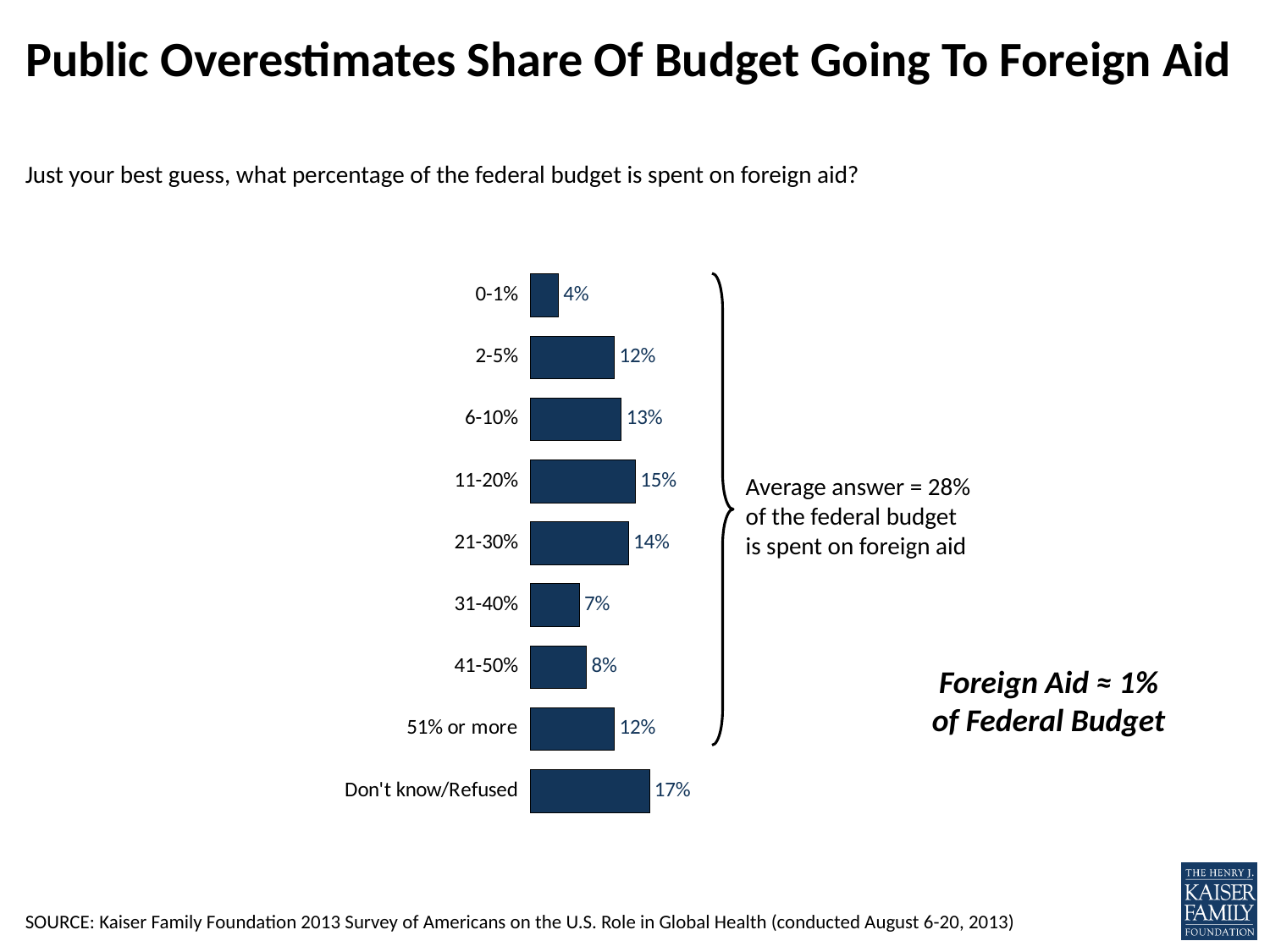
According to the slide, what is the average answer for the share of the federal budget spent on foreign aid? 28% What is the difference between the values for 11-20% and 31-40%? 8% What is the title of the slide? Public Overestimates Share Of Budget Going To Foreign Aid Which category has the lowest value? 0-1% How many categories are shown in the chart? 9 What percentage of respondents answered Don't know/Refused? 17% Which is larger, the value for 6-10% or the value for 41-50%? 6-10% What percentage of respondents guessed 11-20%? 15% What percentage of respondents guessed 0-1%? 4% Which category has the highest value? Don't know/Refused What kind of chart is shown on the slide? Bar chart What is the difference between the values for Don't know/Refused and 51% or more? 5%